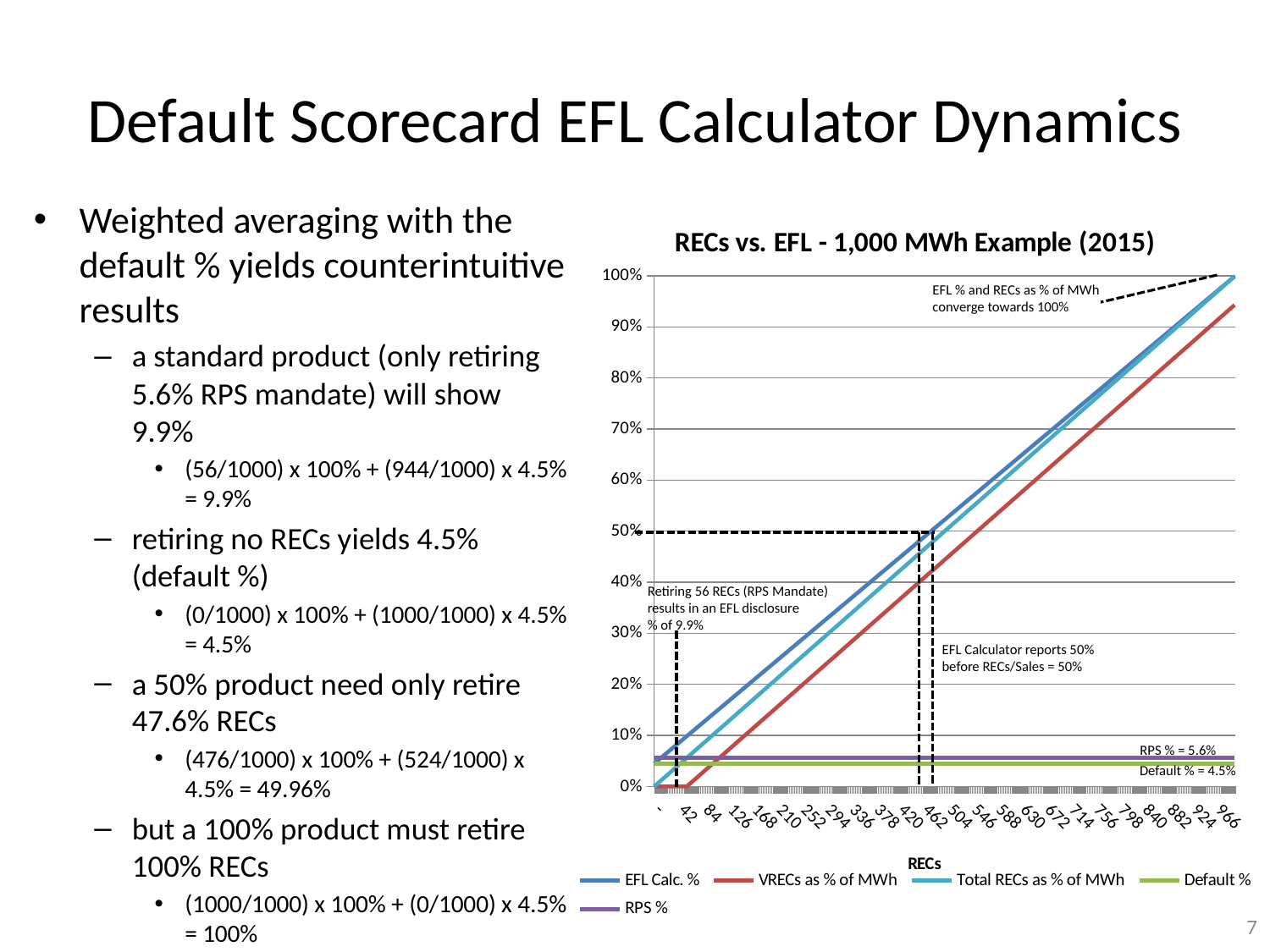
Is the value of EFL Calc. % at 966 RECs greater or less than 90%? greater What value does the chart give for RPS %? 5.6% How many series does the chart's legend list? 5 What is the label of the chart's x axis? RECs What kind of chart is shown on the slide? line chart What is the difference between the RPS % value and the Default % value? 1.1% Which is larger, the RPS % line or the Default % line? RPS % Which series has the lowest value at 966 RECs? Default % Is the value of VRECs as % of MWh at 42 RECs greater or less than 10%? less Does the EFL Calc. % series rise or fall as RECs increase along the x axis? rise What is the title of the chart? RECs vs. EFL - 1,000 MWh Example (2015) What value does the chart give for Default %? 4.5%